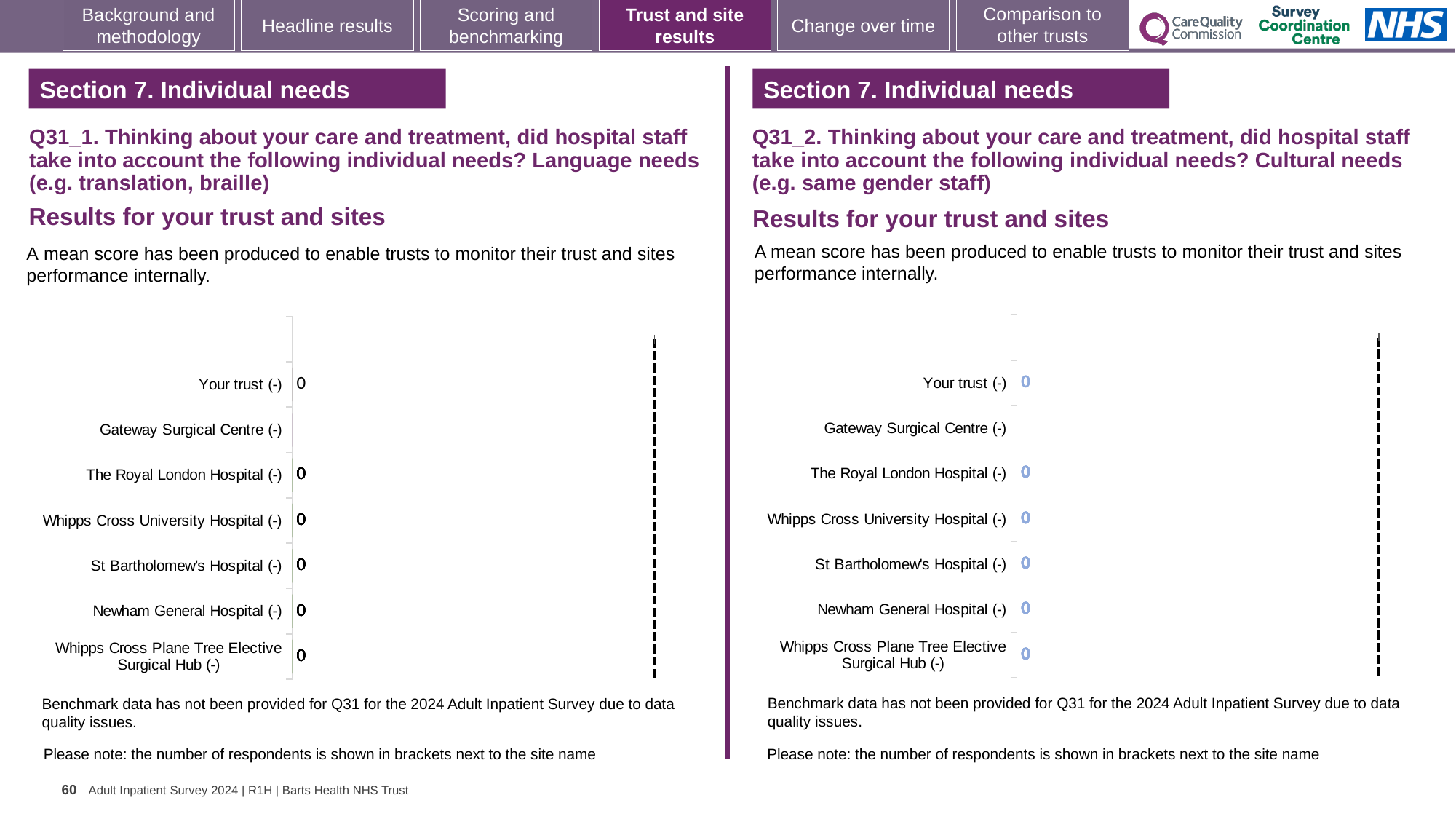
In the left chart (Q31_1, Language needs), what is the value shown for St Bartholomew's Hospital? 0 In the left chart (Q31_1, Language needs), what is the value shown for The Royal London Hospital? 0 Which individual need does the right chart's question (Q31_2) ask about? Cultural needs (e.g. same gender staff) In the left chart (Q31_1, Language needs), what is the value shown for Your trust? 0 In the right chart (Q31_2, Cultural needs), what is the value shown for Whipps Cross Plane Tree Elective Surgical Hub? 0 How many categories are listed on the vertical axis of the left chart (Q31_1, Language needs)? 7 In the right chart (Q31_2, Cultural needs), what is the difference between the values for Your trust and Whipps Cross University Hospital? 0 How many categories are listed on the vertical axis of the right chart (Q31_2, Cultural needs)? 7 What kind of chart is the left chart (Q31_1, Language needs)? Bar chart In the left chart (Q31_1, Language needs), which category has no value label shown next to it? Gateway Surgical Centre (-) In the right chart (Q31_2, Cultural needs), what is the value shown for Newham General Hospital? 0